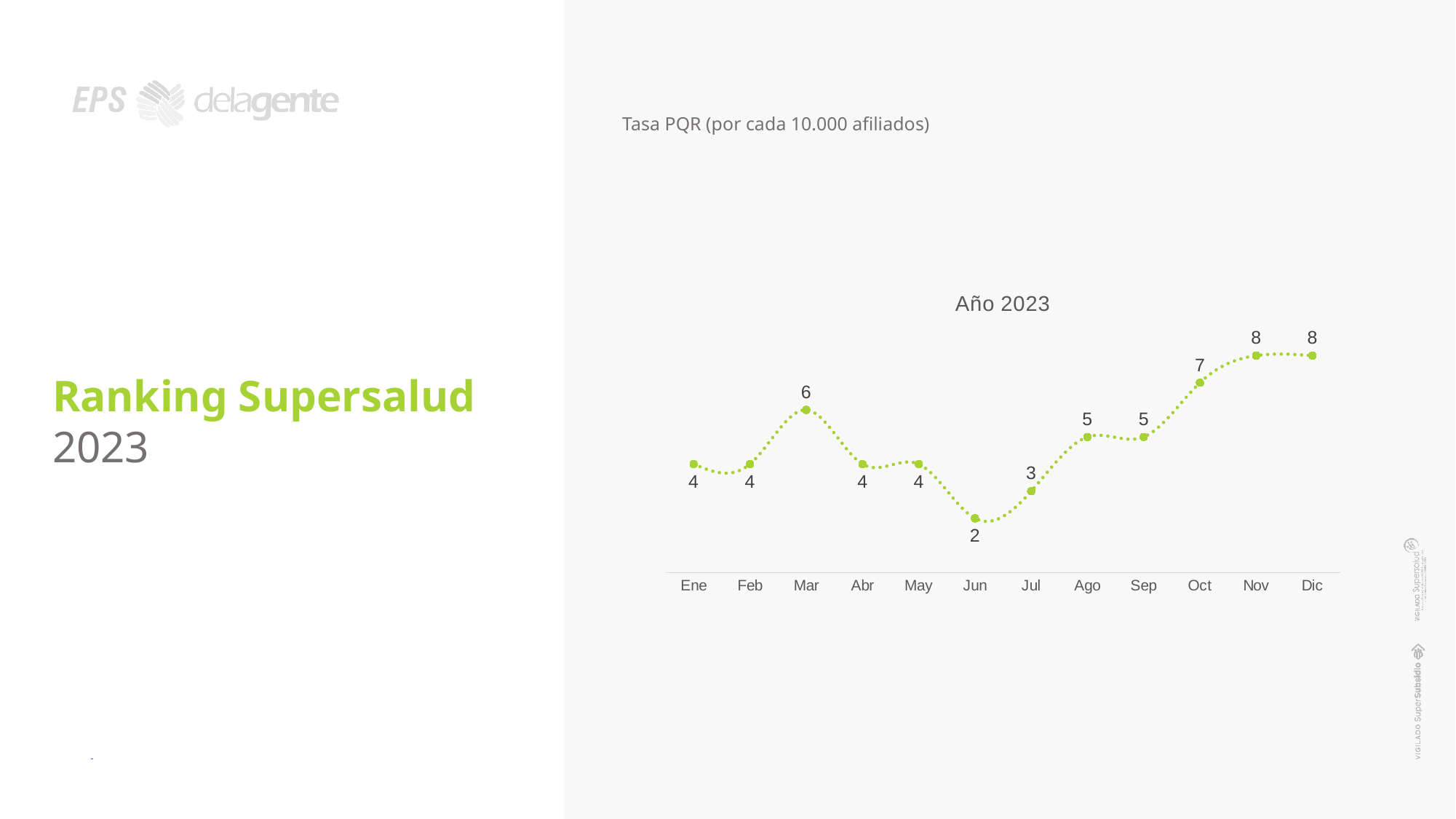
What is the value for Mar? 6 What kind of chart is shown? Line chart What does the text above the chart say the rate is measured per? Por cada 10.000 afiliados Which is larger, the value for Mar or the value for Jul? Mar What is the title of the chart? Año 2023 What is the difference between the values for Dic and Ene? 4 What is the value for Oct? 7 What is the value for Jun? 2 Do the values rise or fall from Jun to Nov? Rise How many months are plotted on the chart? 12 Which month has the lowest value? Jun What is the difference between the values for Mar and Jun? 4